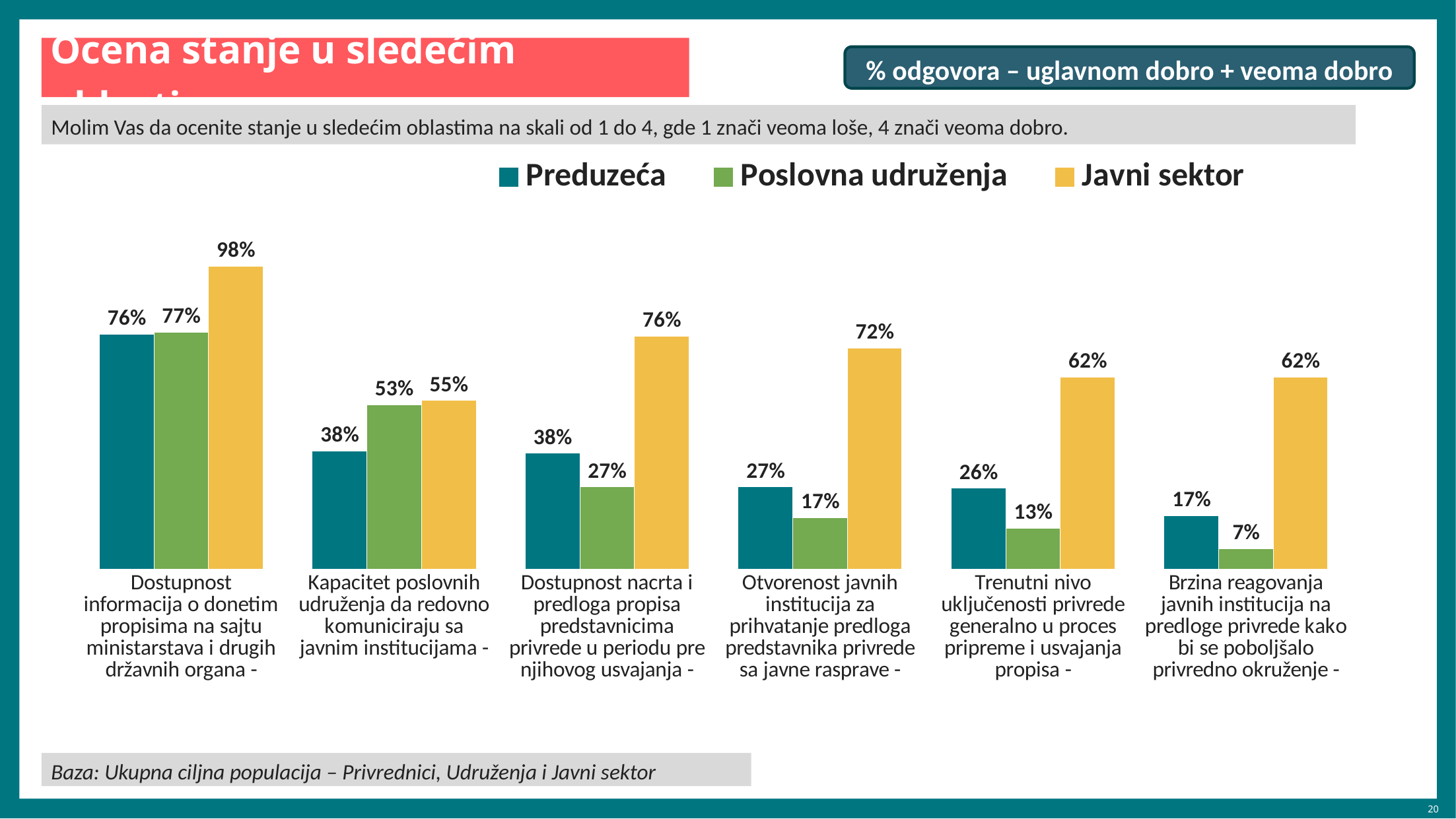
Which category has the highest value for the Preduzeća series? Dostupnost informacija o donetim propisima na sajtu ministarstava i drugih državnih organa What is the value for Poslovna udruženja in the category 'Brzina reagovanja javnih institucija na predloge privrede kako bi se poboljšalo privredno okruženje'? 7% How many series does the legend list? 3 In the category 'Trenutni nivo uključenosti privrede generalno u proces pripreme i usvajanja propisa', which series has the larger value: Preduzeća or Poslovna udruženja? Preduzeća What kind of chart is shown on the slide? Bar chart Which category has the lowest value for the Poslovna udruženja series? Brzina reagovanja javnih institucija na predloge privrede kako bi se poboljšalo privredno okruženje Which colour represents the Javni sektor series in the chart? Yellow What is the value for Javni sektor in the category 'Dostupnost informacija o donetim propisima na sajtu ministarstava i drugih državnih organa'? 98% What is the value for Preduzeća in the category 'Kapacitet poslovnih udruženja da redovno komuniciraju sa javnim institucijama'? 38% What is the difference between the Javni sektor and Preduzeća values in the category 'Dostupnost nacrta i predloga propisa predstavnicima privrede u periodu pre njihovog usvajanja'? 38% What is the value for Javni sektor in the category 'Otvorenost javnih institucija za prihvatanje predloga predstavnika privrede sa javne rasprave'? 72% How many categories are shown on the x axis of the chart? 6